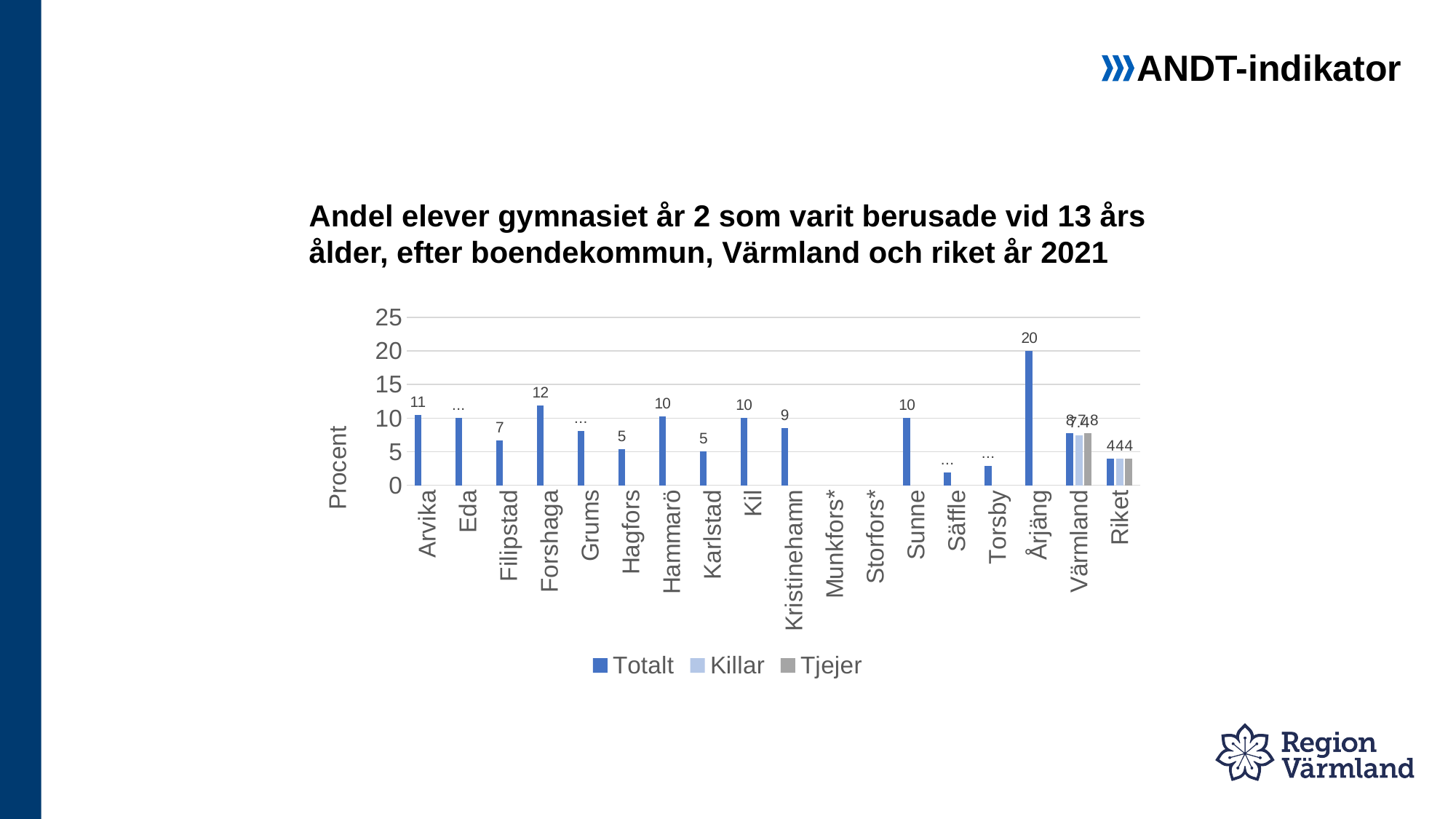
What kind of chart is shown on the slide? bar chart Which municipality has the highest Totalt value? Årjäng What is the Totalt value for Kristinehamn? 9 What is the Totalt value for Forshaga? 12 How many series does the legend list? 3 Is the Totalt value for Säffle greater or less than 5? less What is the Totalt value for Årjäng? 20 What are the three legend entries of the chart? Totalt, Killar, Tjejer What is the difference between the Totalt values for Årjäng and Forshaga? 8 What is the Tjejer value for Riket? 4 How many categories are shown on the x axis? 18 Which has a larger Totalt value, Hammarö or Filipstad? Hammarö